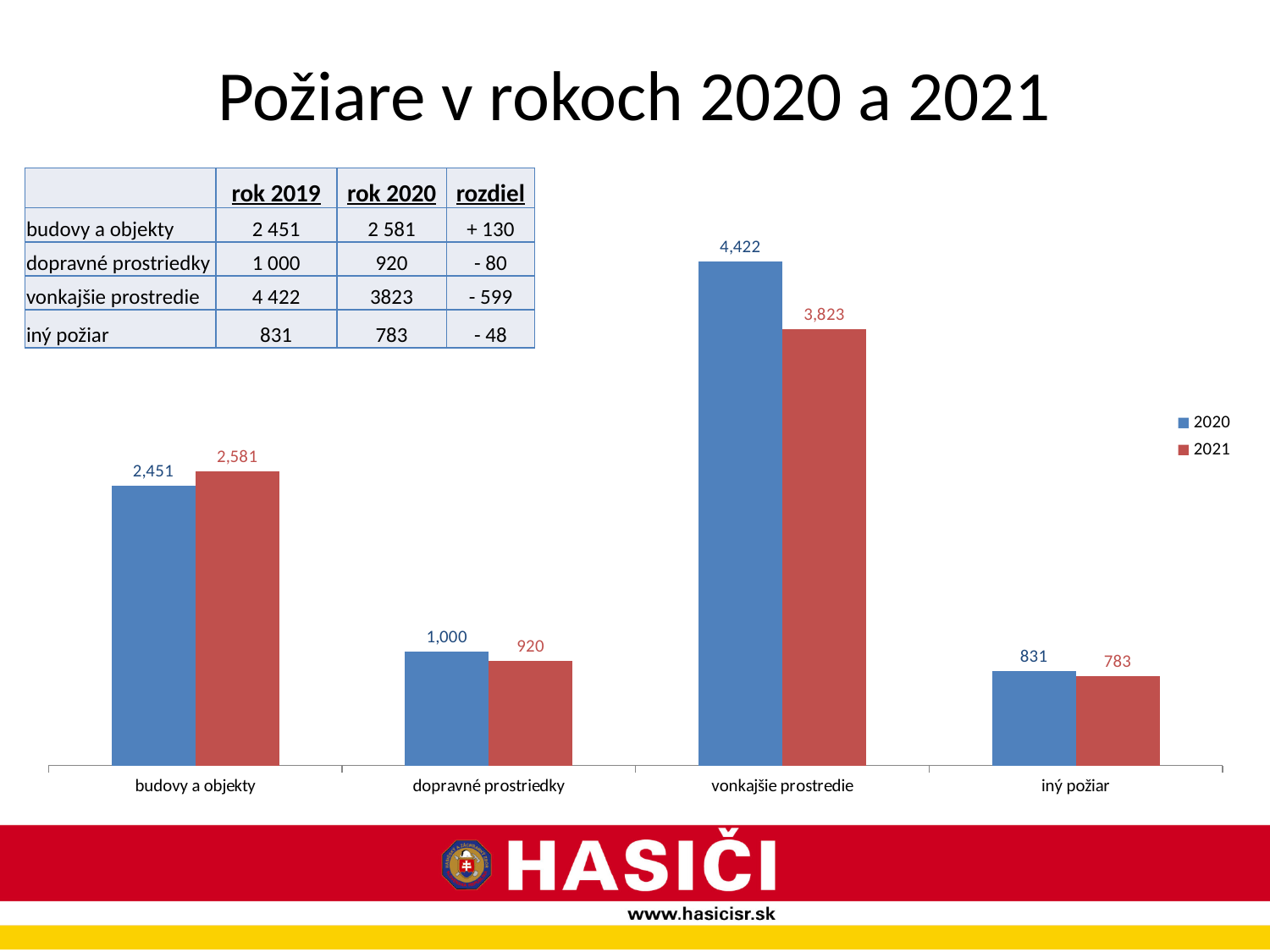
What is the difference between the 2020 and 2021 values for 'vonkajšie prostredie'? 599 What is the value of the 2020 series for 'iný požiar'? 831 Which category has the highest value in the 2020 series? vonkajšie prostredie Which is larger for 'budovy a objekty': the 2020 value or the 2021 value? 2021 What is the value of the 2020 series for 'vonkajšie prostredie'? 4,422 Which series is shown in red in the chart? 2021 What is the value of the 2021 series for 'budovy a objekty'? 2,581 What is the value of the 2021 series for 'dopravné prostriedky'? 920 How many series does the chart legend list? 2 Which category has the lowest value in the 2021 series? iný požiar How many categories are shown on the x axis of the chart? 4 What type of chart is shown on the slide? bar chart